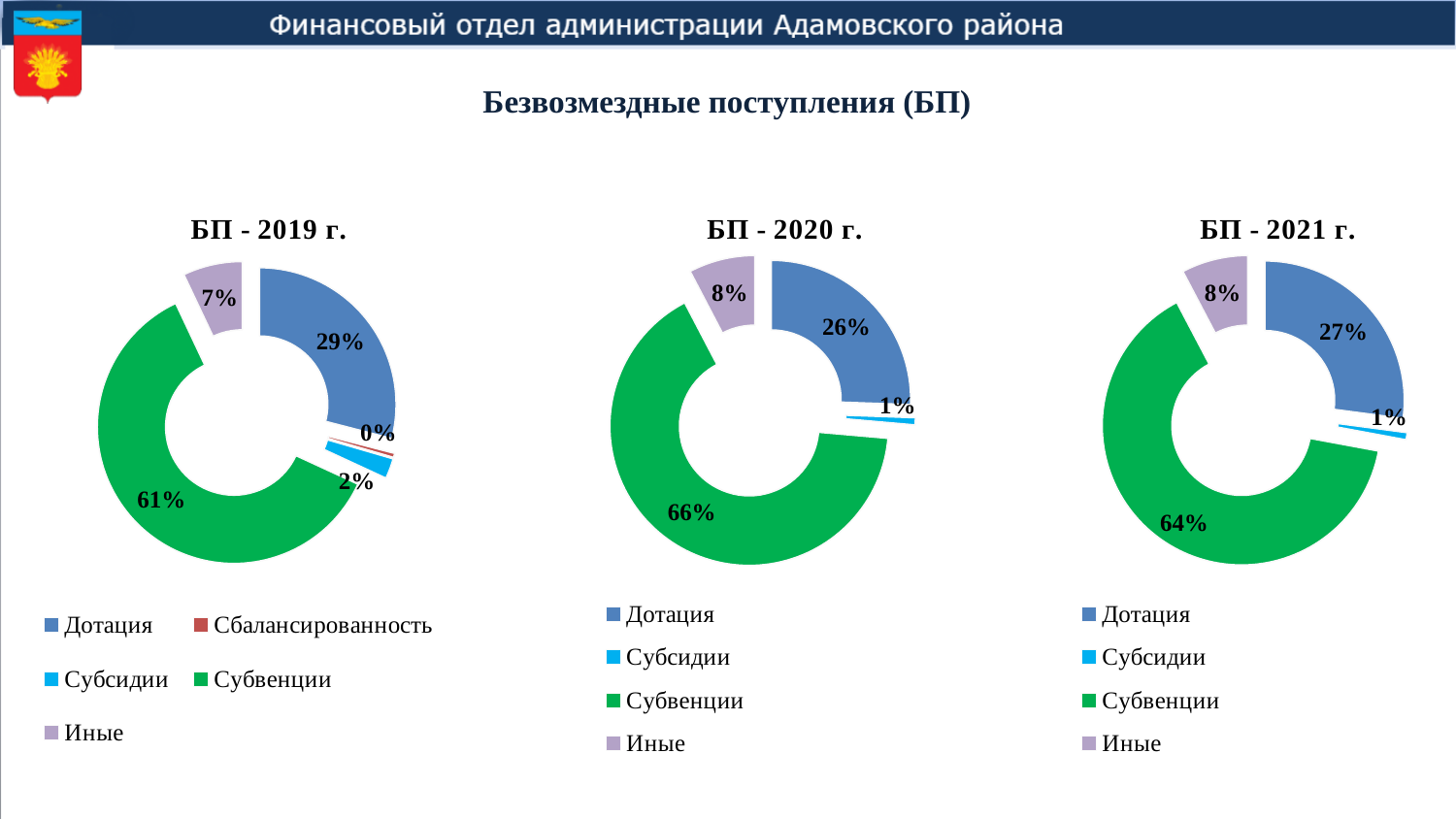
In the chart titled "БП - 2019 г.", which category is shown in red in the legend? Сбалансированность In the chart titled "БП - 2020 г.", what share does Дотация have? 26% How many categories does the legend of the chart titled "БП - 2020 г." list? 4 What type of chart is the chart titled "БП - 2020 г."? Pie (doughnut) chart In the chart titled "БП - 2021 г.", what share does Иные have? 8% In the chart titled "БП - 2021 г.", which category has the largest share? Субвенции In the chart titled "БП - 2021 г.", which is larger: the share of Дотация or the share of Иные? Дотация In the chart titled "БП - 2019 г.", what is the difference between the shares of Субвенции and Дотация? 32% How many categories does the legend of the chart titled "БП - 2019 г." list? 5 In the chart titled "БП - 2019 г.", what share does Субвенции have? 61% In the chart titled "БП - 2020 г.", which category has the smallest share? Субсидии In the chart titled "БП - 2019 г.", what share does Субсидии have? 2%